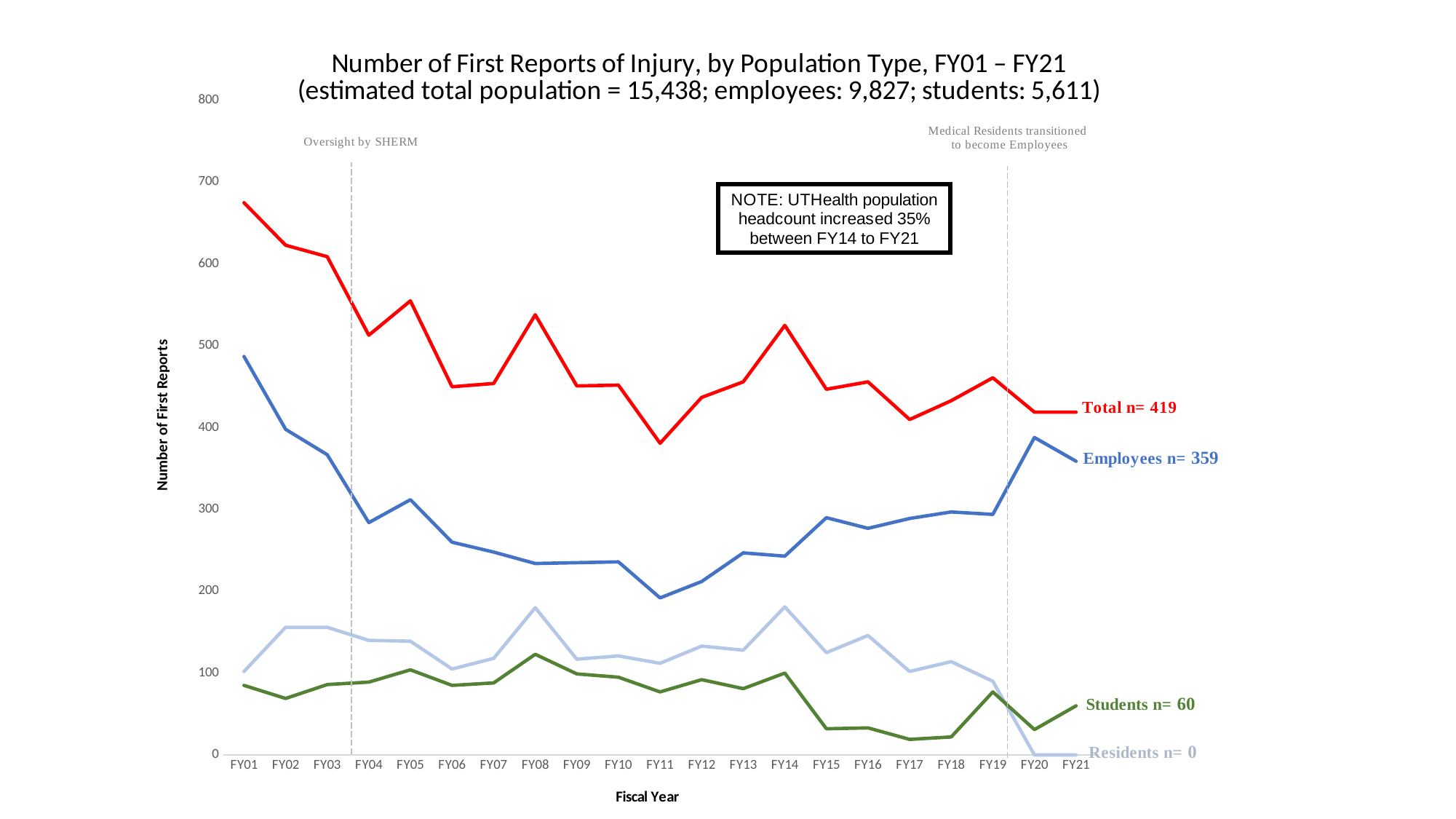
How many fiscal years are plotted along the x axis? 21 In FY21, which is larger: the Employees value or the Students value? Employees Does the Total line generally rise or fall from FY01 to FY21? fall How many population series are labelled on the chart? 4 What kind of chart is shown on the slide? line chart What is the number of first reports for Residents in FY21? 0 What is the difference between the Total and Employees values in FY21? 60 What is the number of first reports for Employees in FY21? 359 Is the Total value for FY01 greater or less than 600? greater What is the number of first reports for Students in FY21? 60 Is the Students value for FY17 greater or less than 100? less What is the Total number of first reports in FY21? 419